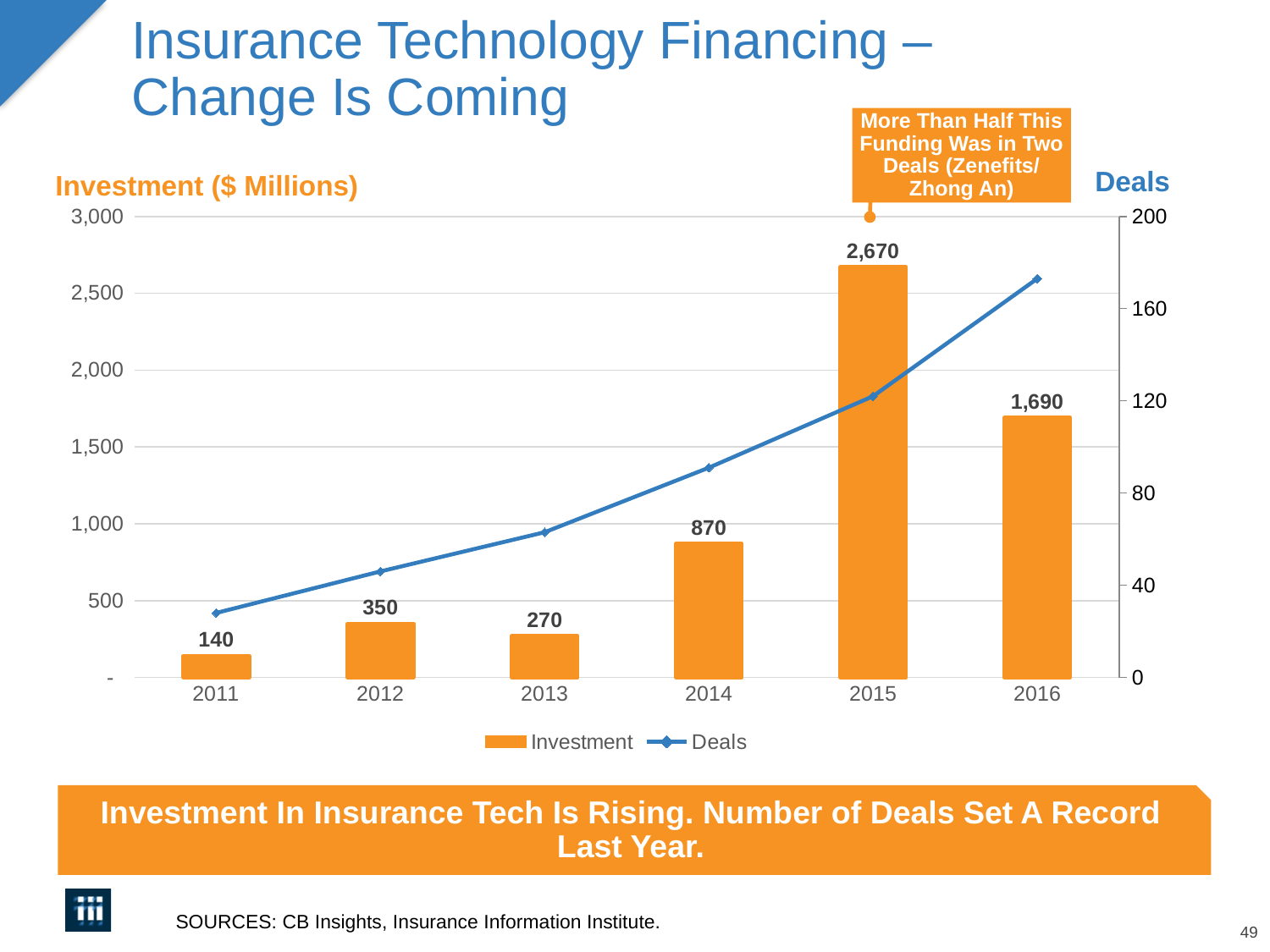
Is the number of deals in 2011 greater or less than 40? less Which year had a larger investment, 2012 or 2013? 2012 Does the number of deals rise or fall from 2011 to 2016? rise How many years are shown on the x axis of the chart? 6 What was the investment value shown for 2011? 140 How many series does the chart legend list? 2 Which year had the lowest investment? 2011 Which year had the highest investment? 2015 What was the investment value shown for 2016? 1,690 Is the number of deals in 2016 greater or less than 160? greater What is the difference between the investment in 2015 and the investment in 2016? 980 What was the investment in insurance technology in 2015, in $ millions? 2,670